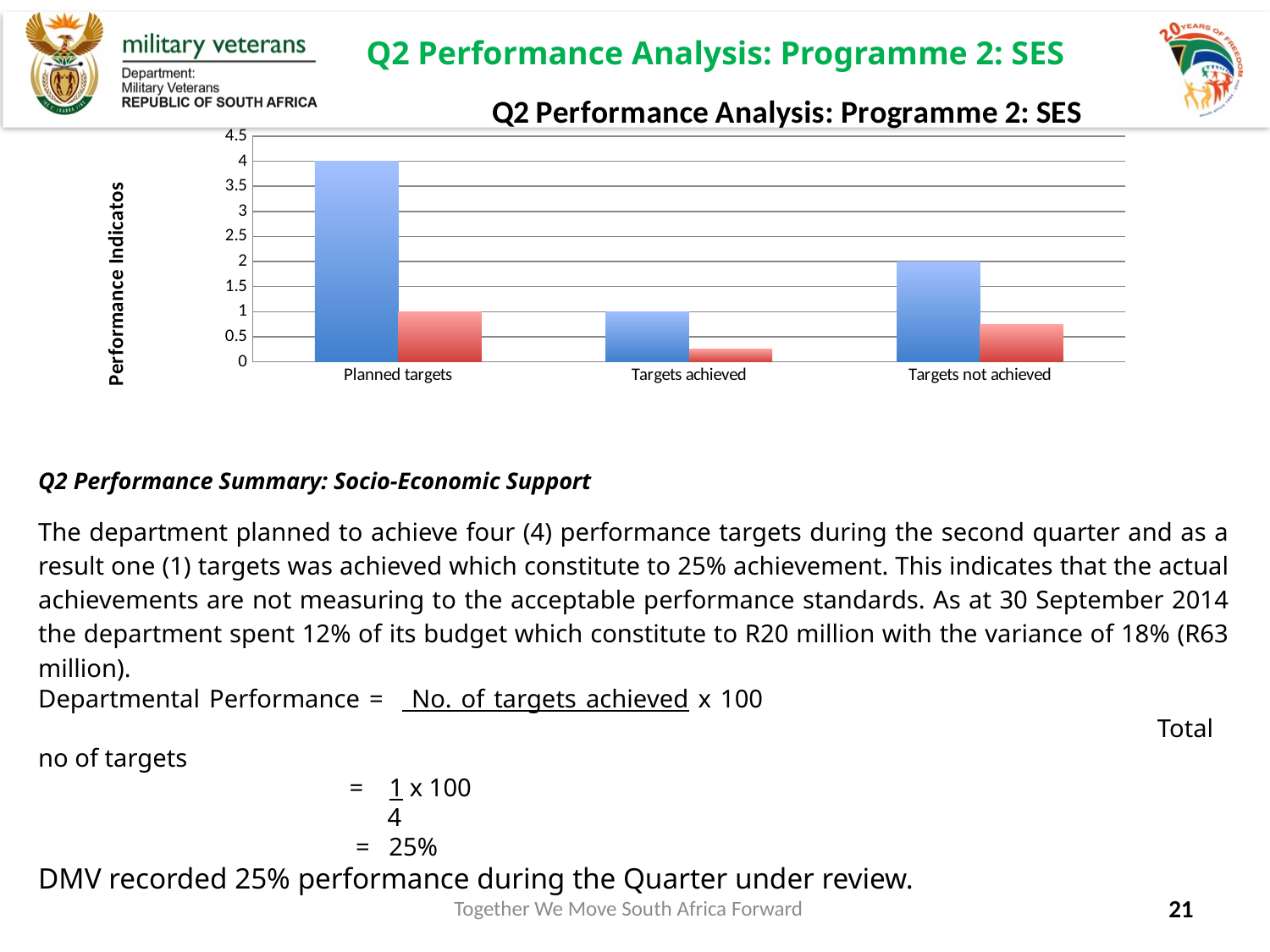
Which blue bar is larger: Targets achieved or Targets not achieved? Targets not achieved Which category has the highest blue bar? Planned targets What is the value of the blue bar for Planned targets? 4 What is the difference between the blue bar for Planned targets and the blue bar for Targets not achieved? 2 What is the value of the blue bar for Targets achieved? 1 What kind of chart is shown on the slide? Bar chart Which category has the lowest blue bar? Targets achieved What is the label on the vertical axis of the chart? Performance Indicatos What is the value of the red bar for Planned targets? 1 How many categories are shown on the x axis of the chart? 3 What is the value of the blue bar for Targets not achieved? 2 Is the value of the red bar for Targets achieved greater or less than 0.5? less